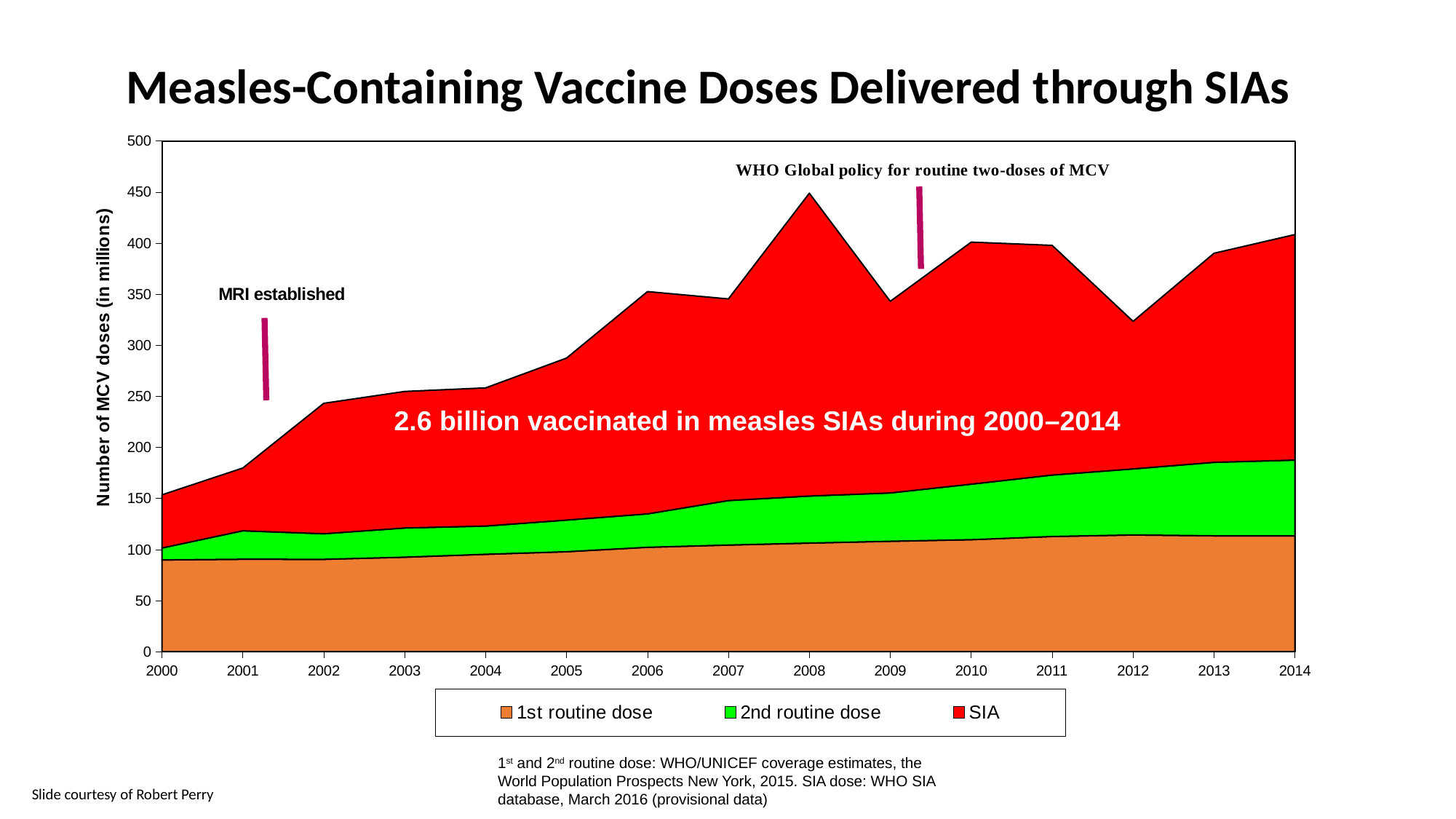
Is the total number of MCV doses in 2008 greater or less than 400? greater In which year is the total number of MCV doses lowest? 2000 Is the total number of MCV doses in 2005 greater or less than 250? greater Is the total number of MCV doses in 2012 greater or less than 350? less Which year has a larger total number of MCV doses, 2008 or 2009? 2008 Does the total number of MCV doses rise or fall from 2000 to 2008? rise What kind of chart is shown on the slide? Stacked area chart How many years are plotted along the x axis? 15 In which year does the total number of MCV doses reach its highest point? 2008 How many series does the legend list? 3 Which series is shown in red in the chart? SIA